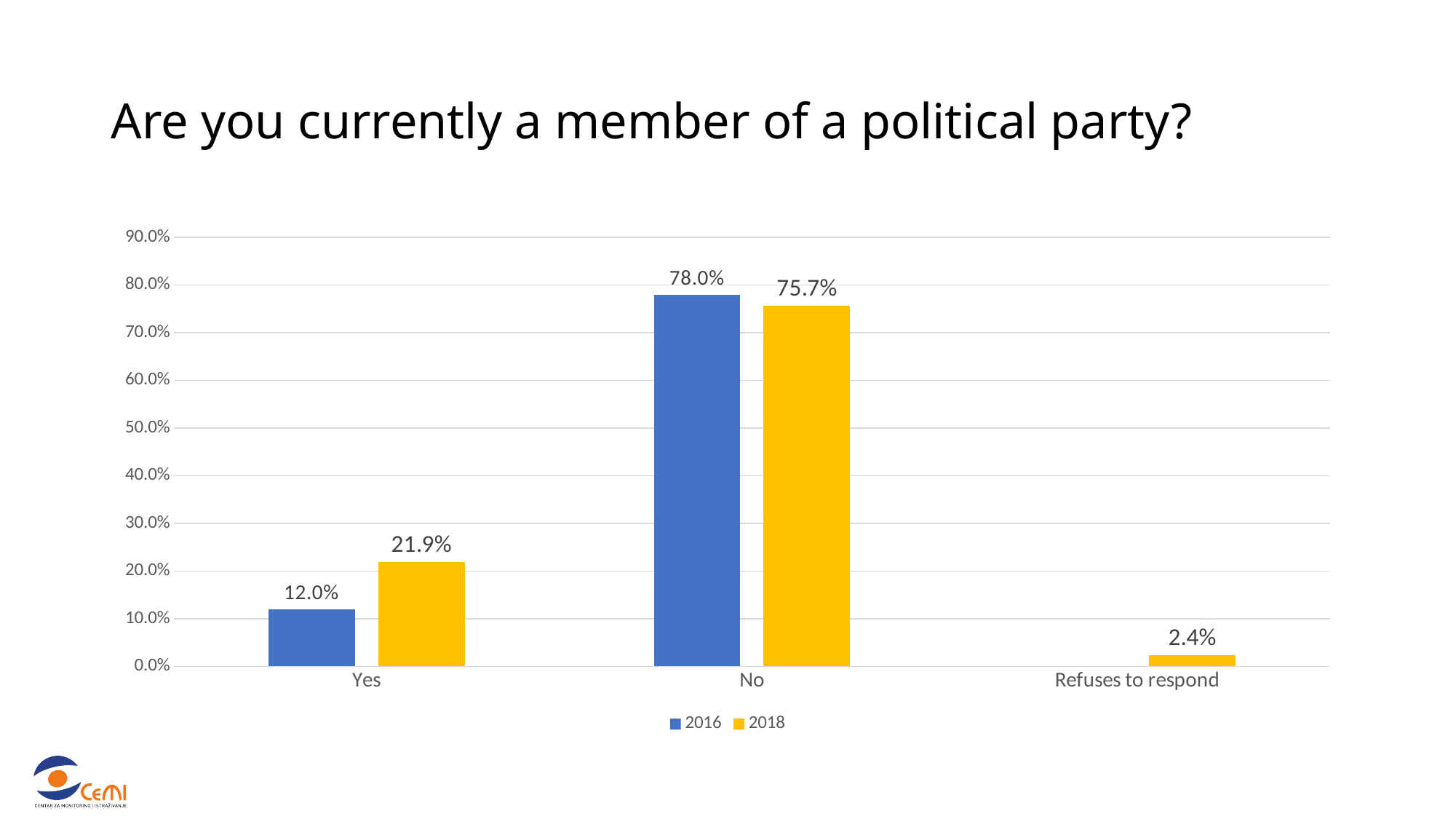
Which category has the lowest value for the 2018 series? Refuses to respond What kind of chart is shown on the slide? Bar chart What percentage of respondents answered "Yes" in 2018? 21.9% Which is larger for the "No" category: the 2016 value or the 2018 value? 2016 How many series does the legend list? 2 How many categories are shown on the x axis? 3 What is the difference between the 2016 and 2018 values for "No"? 2.3% Is the 2016 value for "Yes" greater or less than 20.0%? less What is the difference between the 2018 and 2016 values for "Yes"? 9.9% What percentage of respondents answered "No" in 2016? 78.0% What is the value for "Refuses to respond" in 2018? 2.4% Which category has the highest value for the 2018 series? No